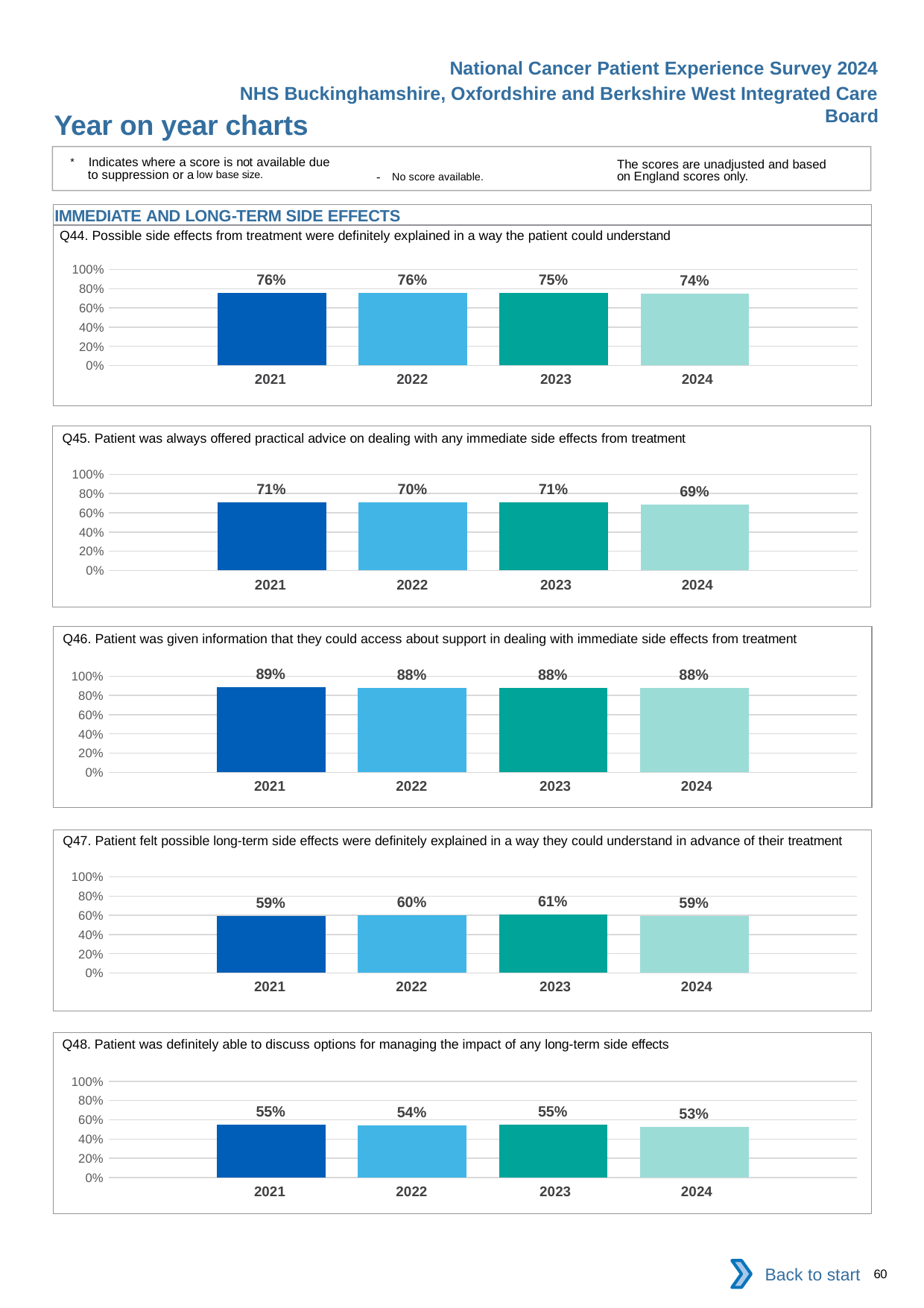
In the Q44 chart, do the values rise or fall from 2021 to 2024? fall In the Q44 chart, what is the value for 2024? 74% In the Q45 chart, what is the difference between the 2021 and 2024 values? 2 percentage points In the Q48 chart, what is the value for 2021? 55% In the Q47 chart, which year has the highest value? 2023 In the Q44 chart, which year has the lowest value? 2024 In the Q48 chart, what is the difference between the 2023 and 2024 values? 2 percentage points In the Q46 chart, how many years are plotted? 4 In the Q46 chart, which year has the highest value? 2021 What type of chart is the Q48 chart? Bar chart In the Q47 chart, is the value for 2022 larger or smaller than the value for 2023? smaller In the Q45 chart, what is the value for 2022? 70%